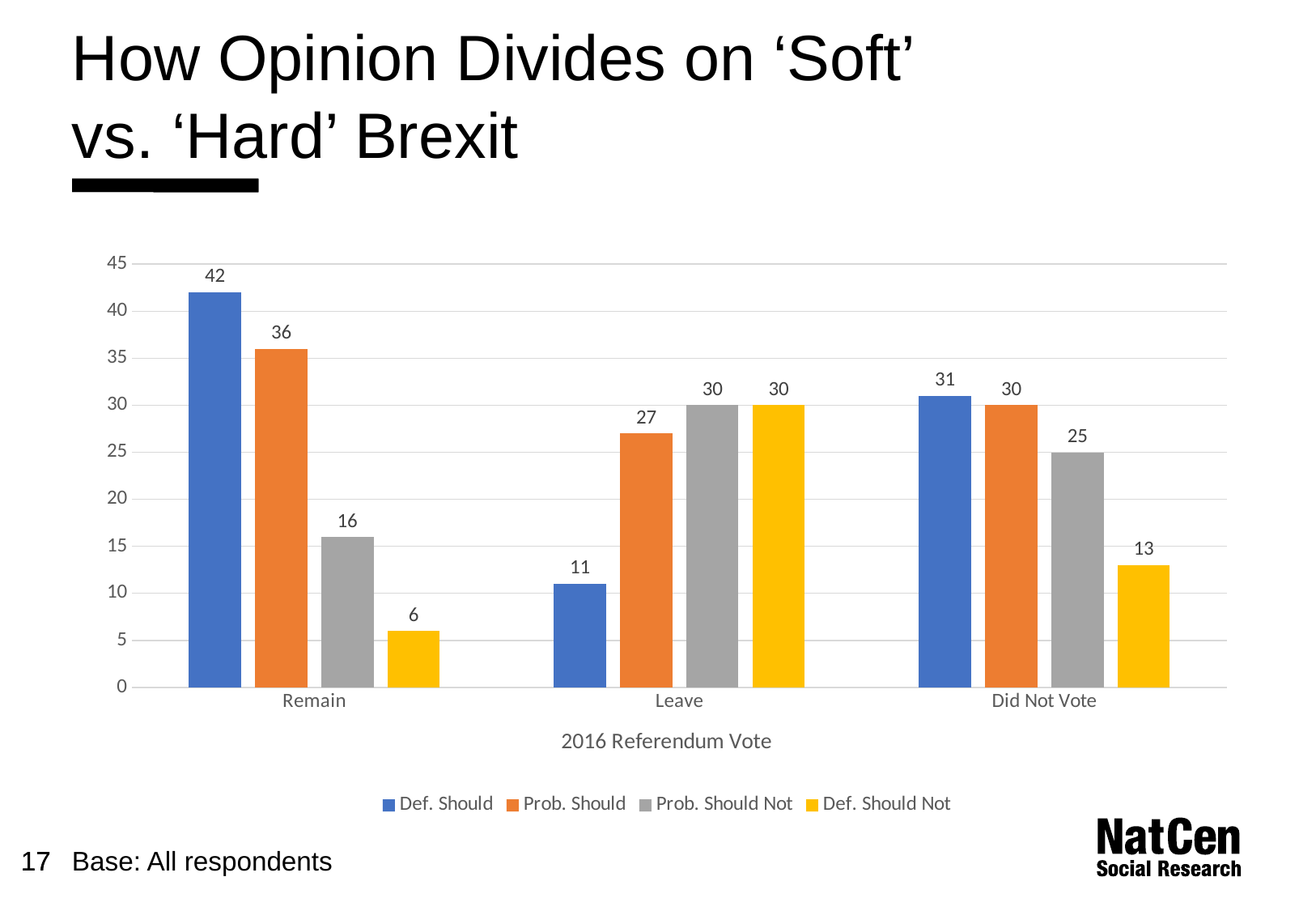
Which category has the highest value for Def. Should? Remain What is the difference between Def. Should and Def. Should Not among Remain voters? 36 What is the value for Prob. Should Not among those who Did Not Vote? 25 Is the value for Prob. Should among Remain voters greater or less than 30? greater Which is larger among Leave voters: Def. Should or Prob. Should? Prob. Should Which category has the lowest value for Def. Should Not? Remain What kind of chart is shown on the slide? Bar chart What is the value for Def. Should among Remain voters? 42 What is the value for Def. Should Not among Leave voters? 30 What is the x-axis title of the chart? 2016 Referendum Vote How many categories are shown on the x axis? 3 How many series does the legend list? 4